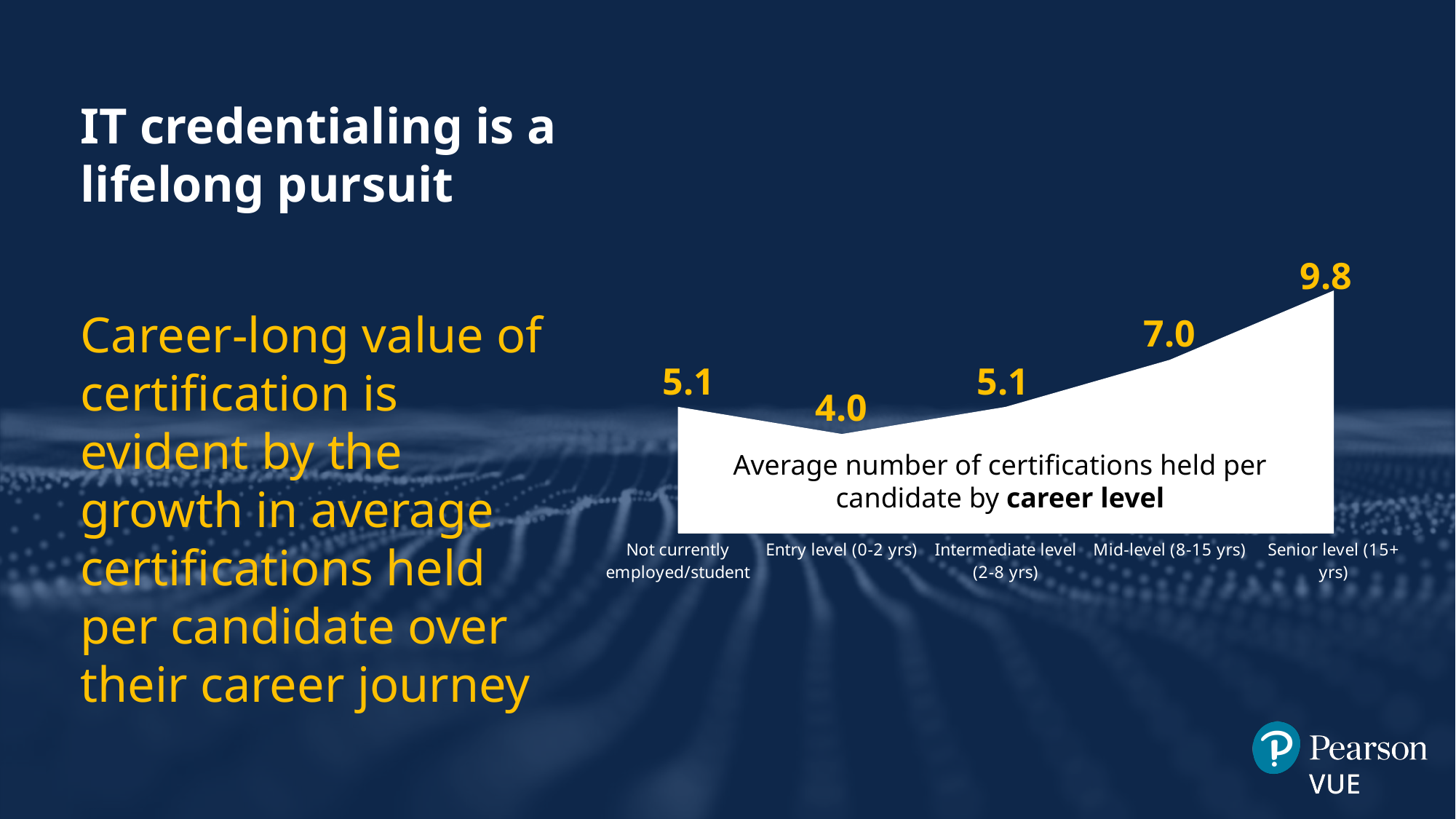
Which is larger, the value for Mid-level (8-15 yrs) or Intermediate level (2-8 yrs)? Mid-level (8-15 yrs) Which career level has the lowest average number of certifications held per candidate? Entry level (0-2 yrs) What is the average number of certifications held per candidate at the Mid-level (8-15 yrs)? 7.0 What is the value for the Not currently employed/student category? 5.1 What is the average number of certifications held per candidate at the Entry level (0-2 yrs)? 4.0 What is the difference between the Senior level (15+ yrs) and Mid-level (8-15 yrs) values? 2.8 What kind of chart is used to show the average number of certifications by career level? Area chart What is the average number of certifications held per candidate at the Senior level (15+ yrs)? 9.8 What is the difference between the Intermediate level (2-8 yrs) and Entry level (0-2 yrs) values? 1.1 Do the values rise or fall from Entry level (0-2 yrs) to Senior level (15+ yrs)? Rise Which career level has the highest average number of certifications held per candidate? Senior level (15+ yrs) How many career level categories are shown on the chart? 5